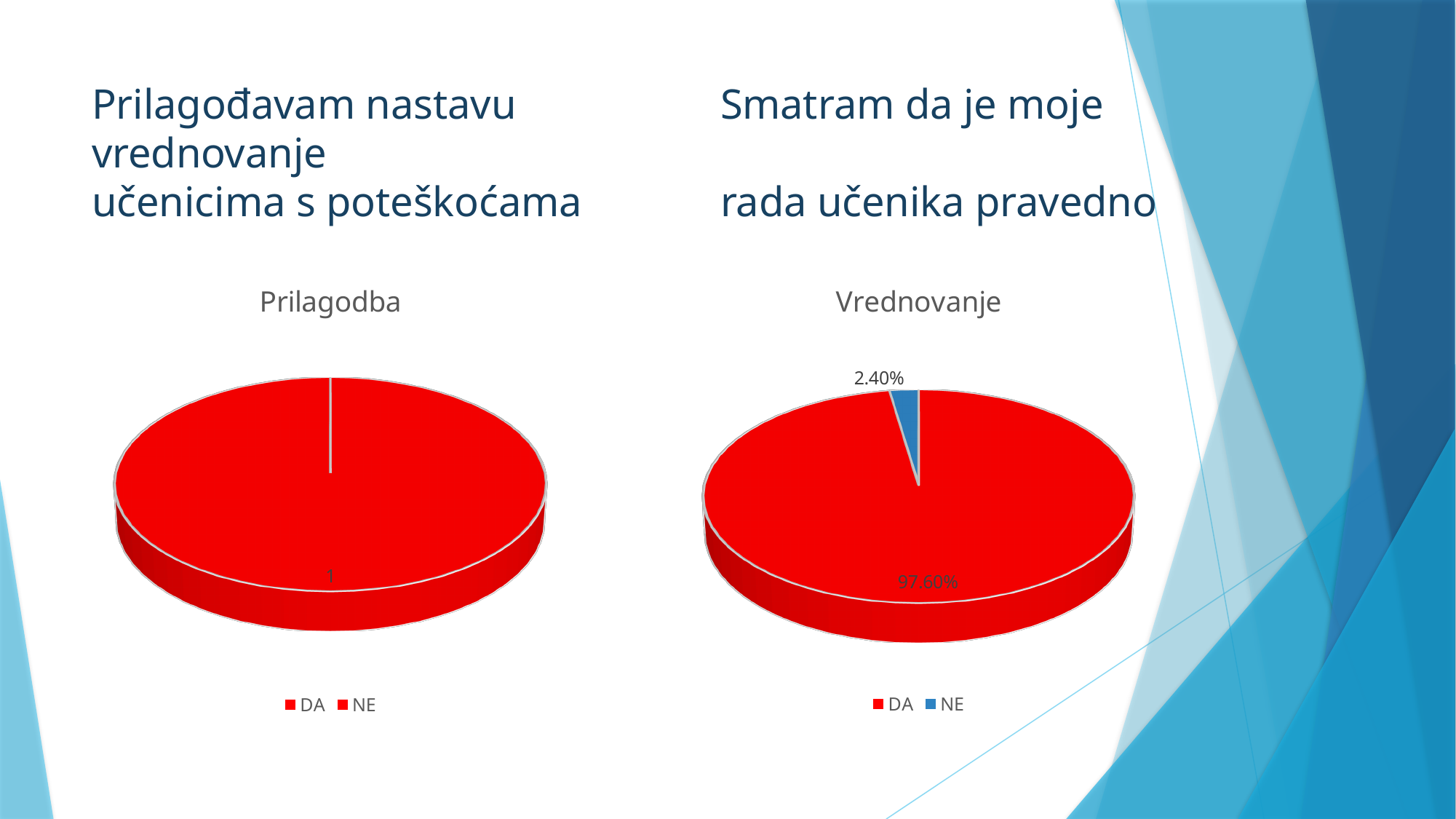
In the chart titled "Vrednovanje", what colour is the NE slice? Blue In the chart titled "Vrednovanje", what is the value for DA? 97.60% In the chart titled "Vrednovanje", what is the difference between the DA and NE values? 95.20% In the chart titled "Vrednovanje", what is the value for NE? 2.40% What is the title of the chart on the left side of the slide? Prilagodba What kind of chart is the chart titled "Vrednovanje"? Pie chart In the chart titled "Prilagodba", how many entries does the legend list? 2 In the chart titled "Vrednovanje", how many categories does the legend list? 2 In the chart titled "Vrednovanje", which category has the largest slice? DA What kind of chart is the chart titled "Prilagodba"? Pie chart In the chart titled "Vrednovanje", which is larger, DA or NE? DA In the chart titled "Vrednovanje", which category has the smallest slice? NE